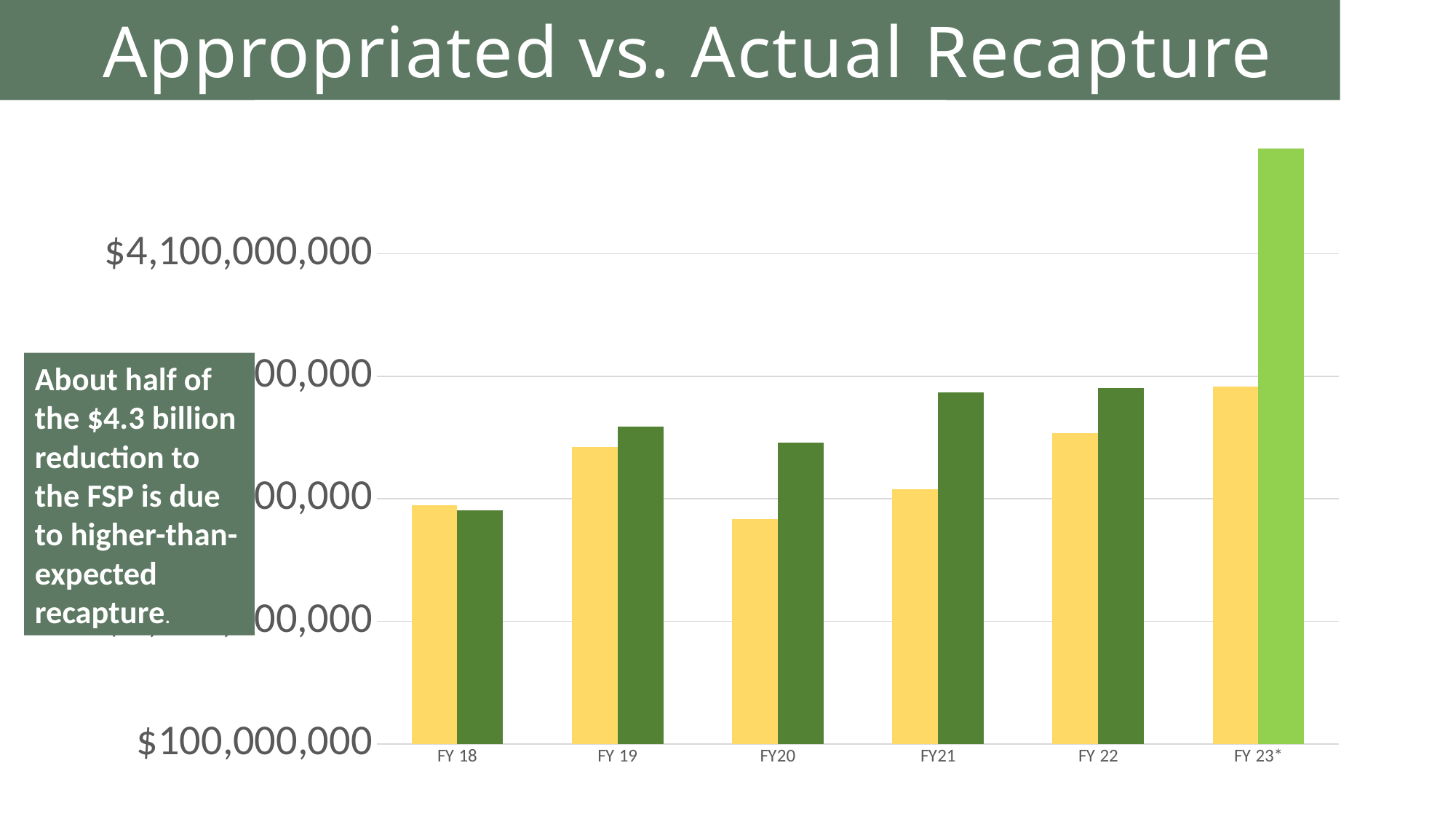
Among the green bars, which fiscal year has the lowest value? FY 18 What kind of chart is shown on the slide? bar chart For FY 23*, which bar is larger, the yellow bar or the green bar? green bar How many fiscal-year categories are shown on the x axis? 6 Which fiscal year has the tallest bar in the chart? FY 23* How many bars are plotted for each fiscal year? 2 Is the green bar for FY 22 greater or less than $4,100,000,000? less What is the label of the highest tick shown on the y axis? $4,100,000,000 Among the yellow bars, which fiscal year has the lowest value? FY20 Is the green bar for FY 23* greater or less than $4,100,000,000? greater For FY21, which bar is larger, the yellow bar or the green bar? green bar What is the title of the chart? Appropriated vs. Actual Recapture